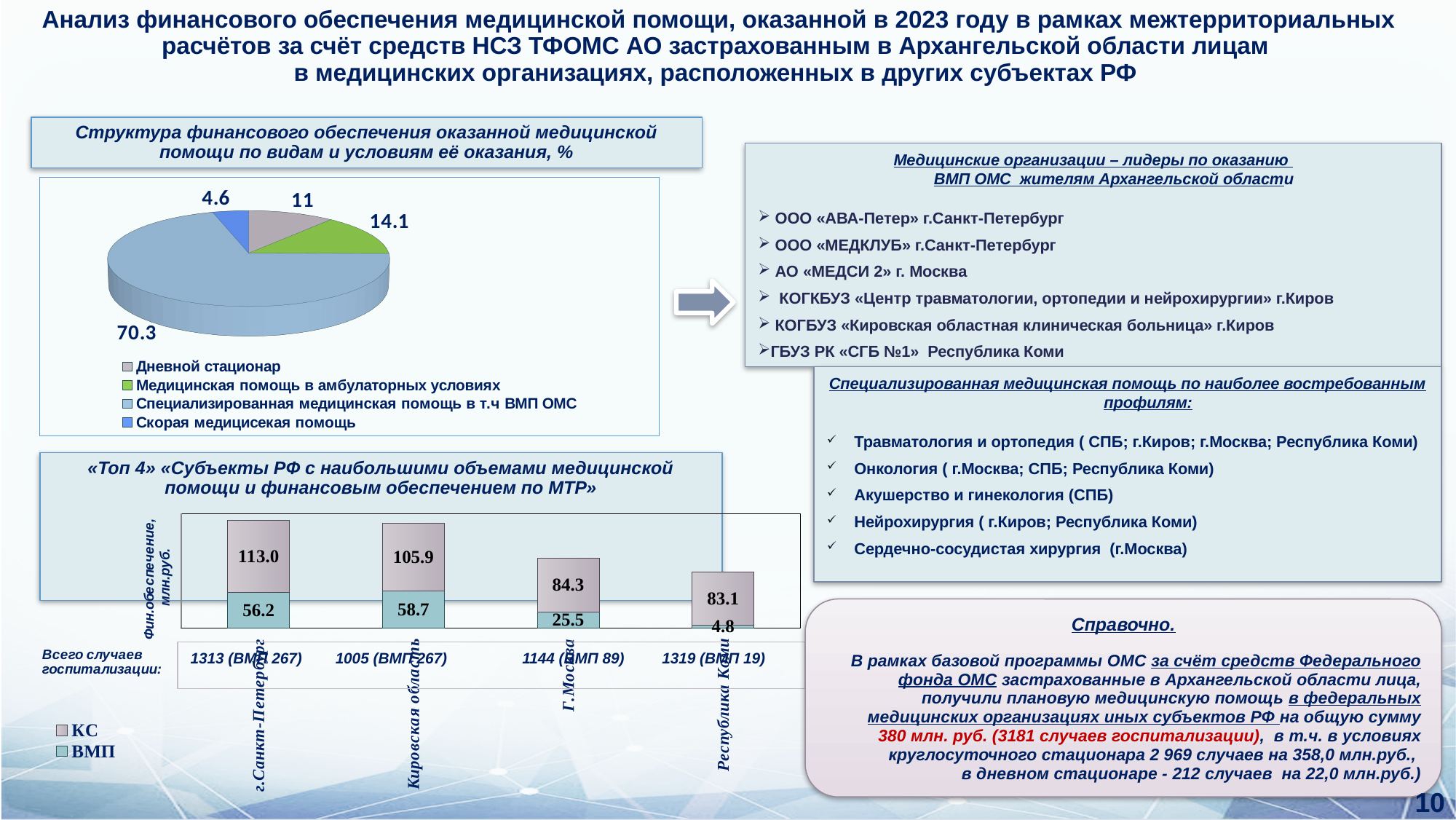
On the bar chart '«Топ 4» «Субъекты РФ с наибольшими объемами медицинской помощи и финансовым обеспечением по МТР»', what is the КС value for г.Санкт-Петербург? 113.0 On the pie chart 'Структура финансового обеспечения оказанной медицинской помощи', which category has the largest share? Специализированная медицинская помощь в т.ч ВМП ОМС On the pie chart 'Структура финансового обеспечения оказанной медицинской помощи', what is the value for 'Медицинская помощь в амбулаторных условиях'? 14.1 On the bar chart '«Топ 4» «Субъекты РФ...»', which subject has the highest ВМП value? Кировская область On the bar chart '«Топ 4» «Субъекты РФ...»', what is the difference between the КС values for г.Санкт-Петербург and Кировская область? 7.1 On the bar chart '«Топ 4» «Субъекты РФ...»', how many series does the legend list? 2 On the pie chart 'Структура финансового обеспечения оказанной медицинской помощи', which category has the smallest share? Скорая медицисекая помощь On the pie chart 'Структура финансового обеспечения оказанной медицинской помощи', how many categories does the legend list? 4 On the bar chart '«Топ 4» «Субъекты РФ...»', what is the ВМП value for Республика Коми? 4.8 On the bar chart '«Топ 4» «Субъекты РФ...»', what is the total of the stacked bar for Г.Москва? 109.8 On the pie chart 'Структура финансового обеспечения оказанной медицинской помощи по видам и условиям её оказания, %', what is the value for 'Дневной стационар'? 11 What kind of chart is used for '«Топ 4» «Субъекты РФ с наибольшими объемами медицинской помощи и финансовым обеспечением по МТР»'? Stacked bar chart